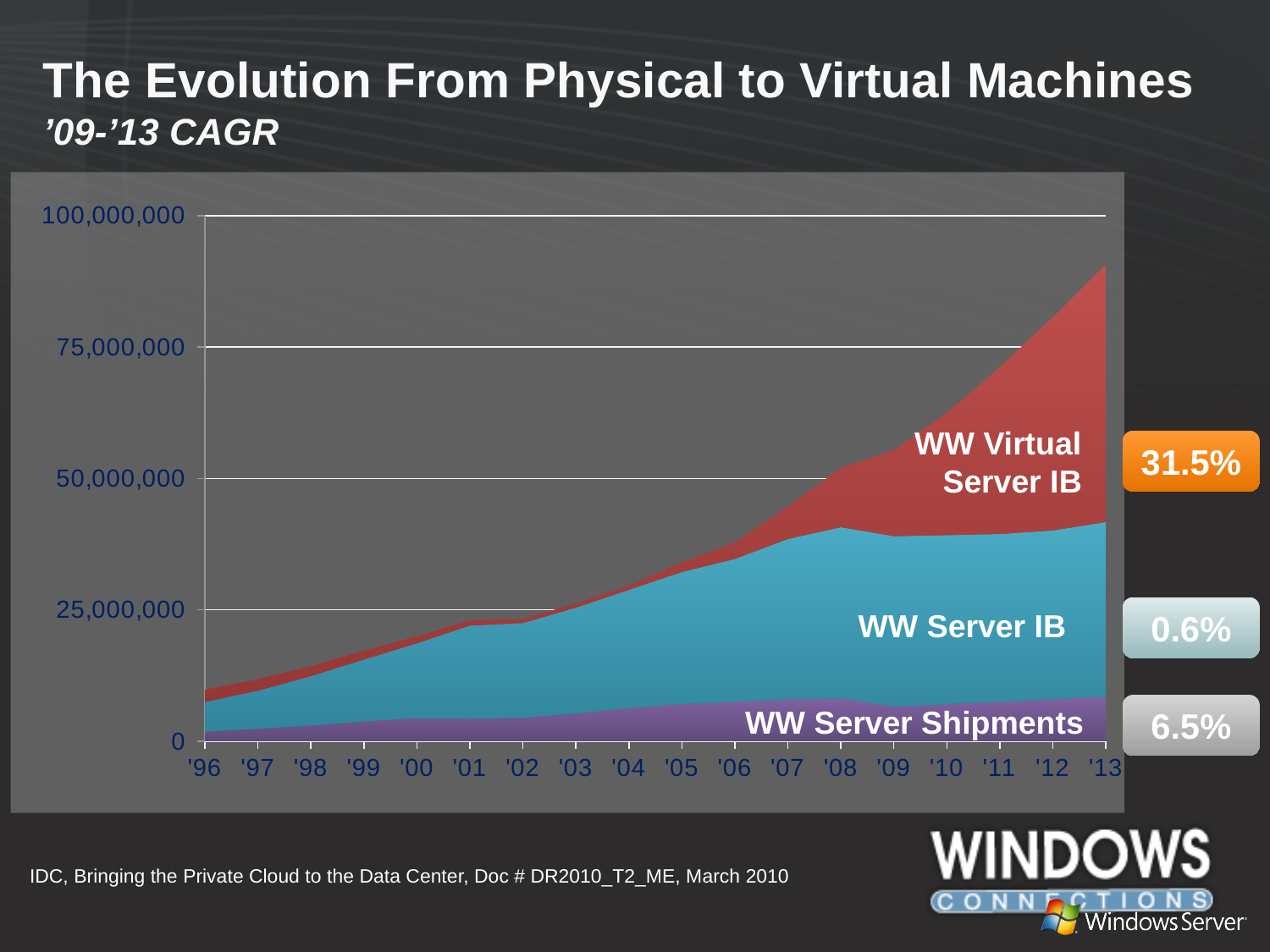
Is the total stacked value in '96 greater or less than 25,000,000? less Is the total stacked value in '13 greater or less than 75,000,000? greater How many series are plotted in the chart? 3 What is the '09-'13 CAGR shown for WW Server IB? 0.6% What is the first year shown on the x axis of the chart? '96 Does the total stacked value rise or fall from '96 to '13? rise Which series has the highest '09-'13 CAGR? WW Virtual Server IB What kind of chart is shown on the slide? Stacked area chart What is the '09-'13 CAGR shown for WW Virtual Server IB? 31.5% What is the '09-'13 CAGR shown for WW Server Shipments? 6.5% Which series has the lowest '09-'13 CAGR? WW Server IB How many years are shown along the x axis of the chart? 18